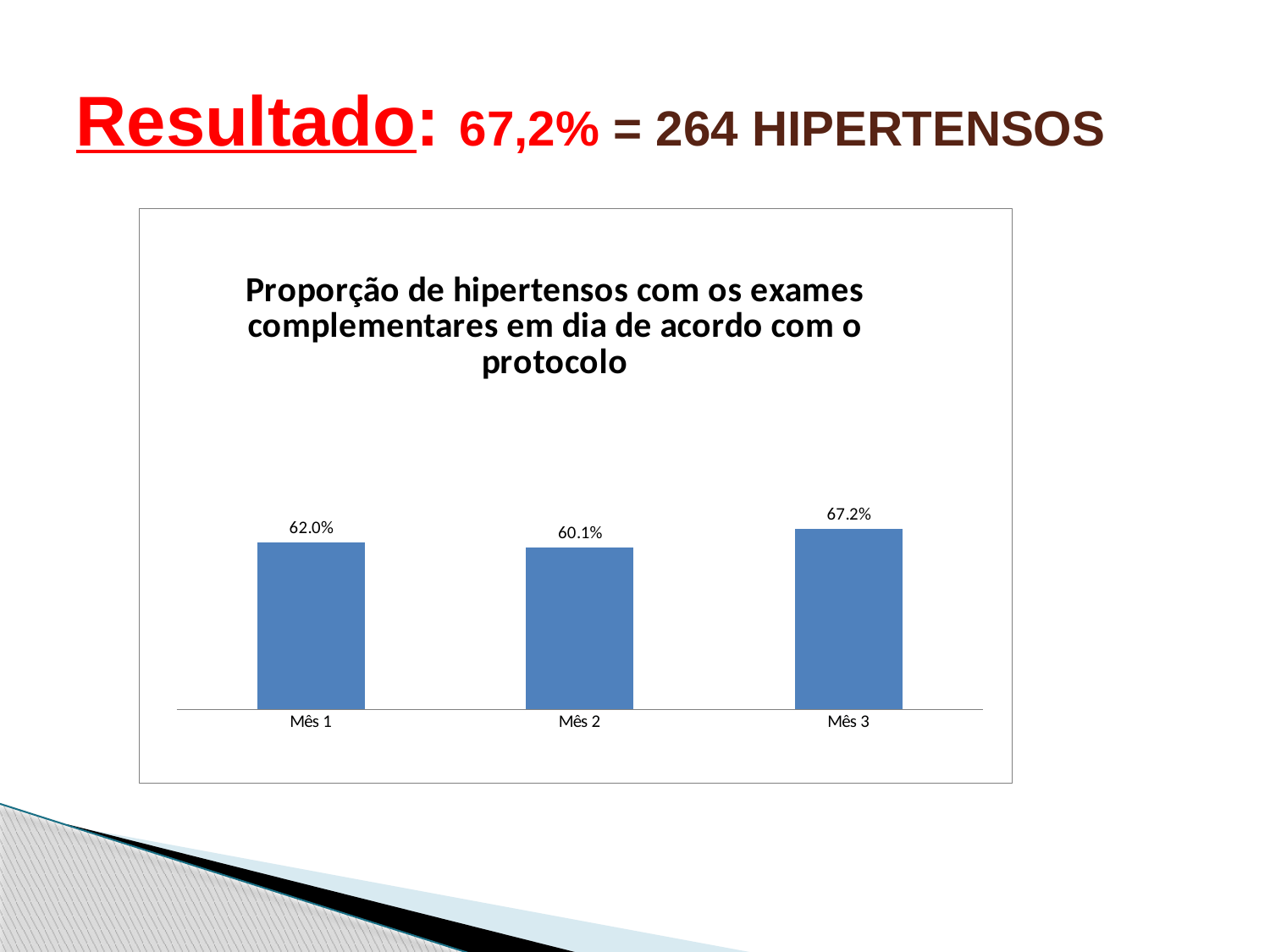
Which month has the lowest value? Mês 2 How many months are shown on the x axis? 3 Which month has the highest value? Mês 3 What is the title of the chart? Proporção de hipertensos com os exames complementares em dia de acordo com o protocolo What colour are the bars in the chart? Blue What is the value for Mês 3? 67.2% What is the difference between the values for Mês 1 and Mês 2? 1.9% What kind of chart is shown on the slide? Bar chart What is the value for Mês 1? 62.0% What is the difference between the values for Mês 3 and Mês 2? 7.1% Which is larger, the value for Mês 1 or the value for Mês 3? Mês 3 What is the value for Mês 2? 60.1%